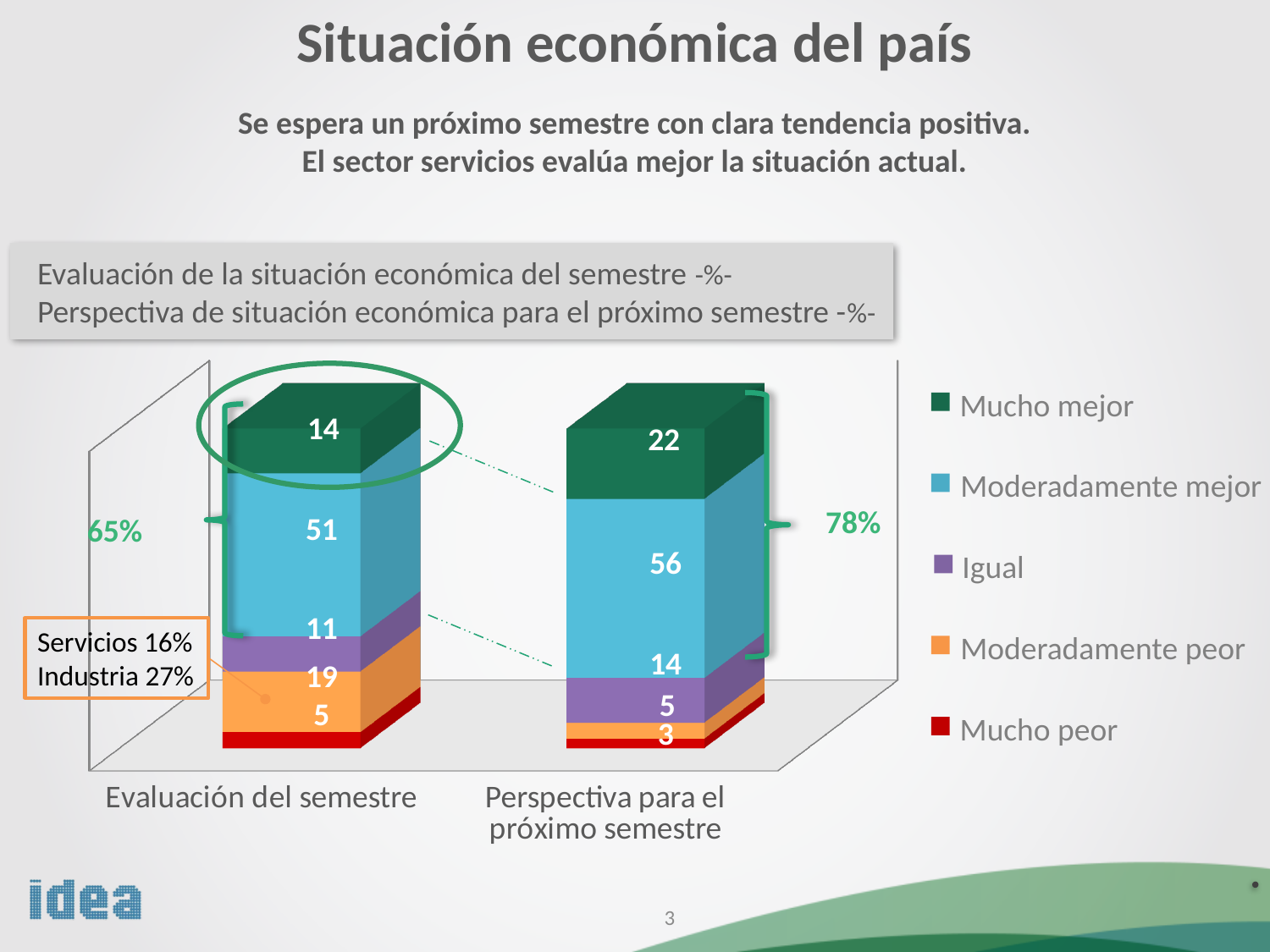
What is the value of "Igual" for "Perspectiva para el próximo semestre"? 14 What is the difference between the "Moderadamente mejor" values for "Perspectiva para el próximo semestre" and "Evaluación del semestre"? 5 Which bar has the larger "Mucho mejor" value, "Evaluación del semestre" or "Perspectiva para el próximo semestre"? Perspectiva para el próximo semestre What is the value of "Mucho mejor" for "Perspectiva para el próximo semestre"? 22 What is the value of "Moderadamente mejor" for "Evaluación del semestre"? 51 What kind of chart is shown on the slide? stacked bar chart What is the total of the stacked bar for "Evaluación del semestre"? 100 How many categories (bars) are plotted on the x axis? 2 How many series does the legend list? 5 Which series has the highest value in the "Perspectiva para el próximo semestre" bar? Moderadamente mejor What is the value of "Moderadamente peor" for "Evaluación del semestre"? 19 Which series has the lowest value in the "Evaluación del semestre" bar? Mucho peor